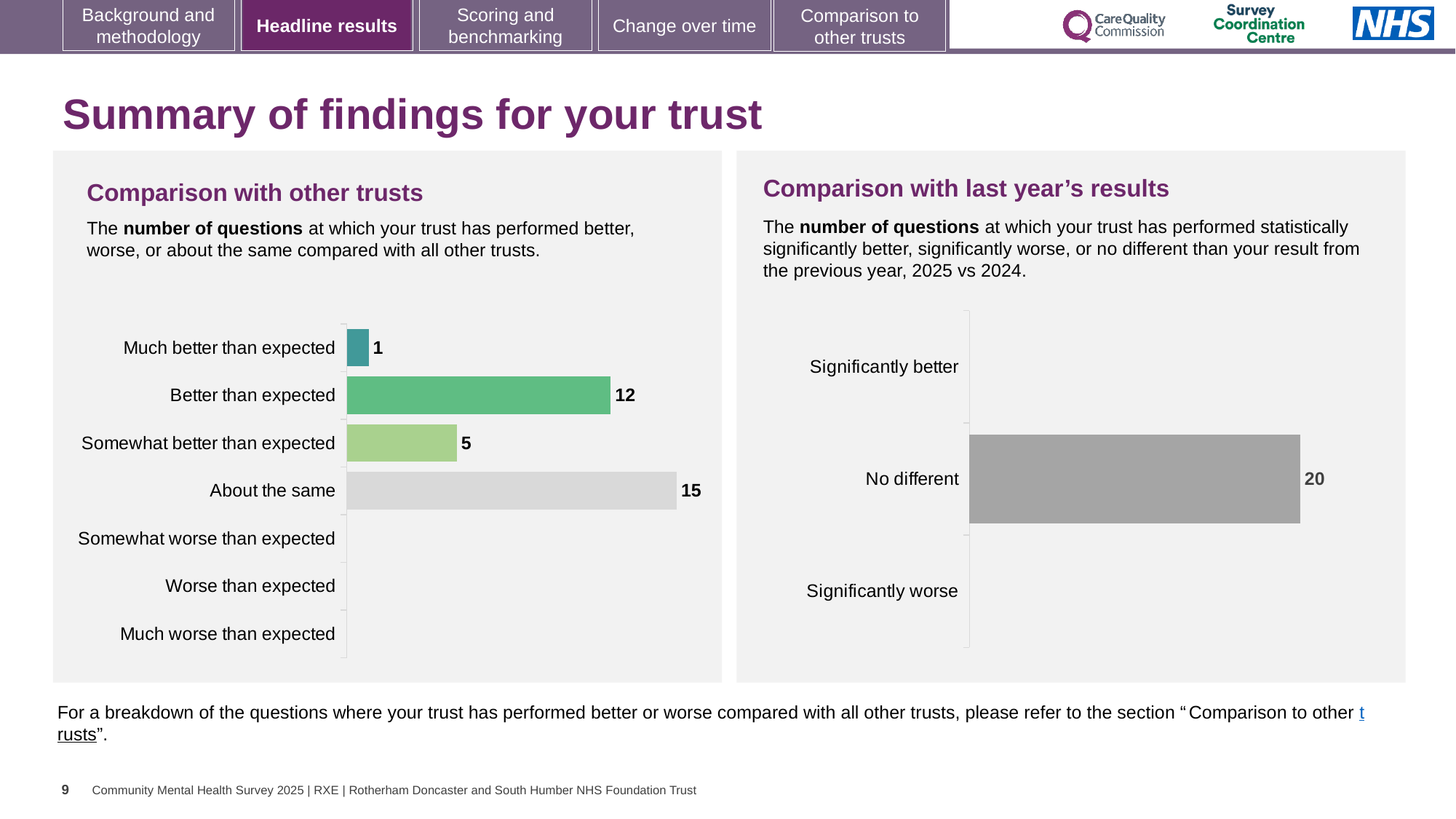
In the 'Comparison with other trusts' chart, what is the value for 'Much better than expected'? 1 In the 'Comparison with other trusts' chart, what is the difference between 'About the same' and 'Better than expected'? 3 In the 'Comparison with other trusts' chart, which category has the highest value? About the same How many categories are listed on the 'Comparison with other trusts' chart? 7 In the 'Comparison with other trusts' chart, which is larger: 'Better than expected' or 'Somewhat better than expected'? Better than expected In the 'Comparison with other trusts' chart, what is the value for 'About the same'? 15 In the 'Comparison with other trusts' chart, what is the value for 'Better than expected'? 12 In the 'Comparison with last year's results' chart, what is the value for 'No different'? 20 How many categories are listed on the 'Comparison with last year's results' chart? 3 In the 'Comparison with other trusts' chart, what is the value for 'Somewhat better than expected'? 5 In the 'Comparison with last year's results' chart, which category has the highest value? No different What kind of chart is the 'Comparison with other trusts' chart? Bar chart